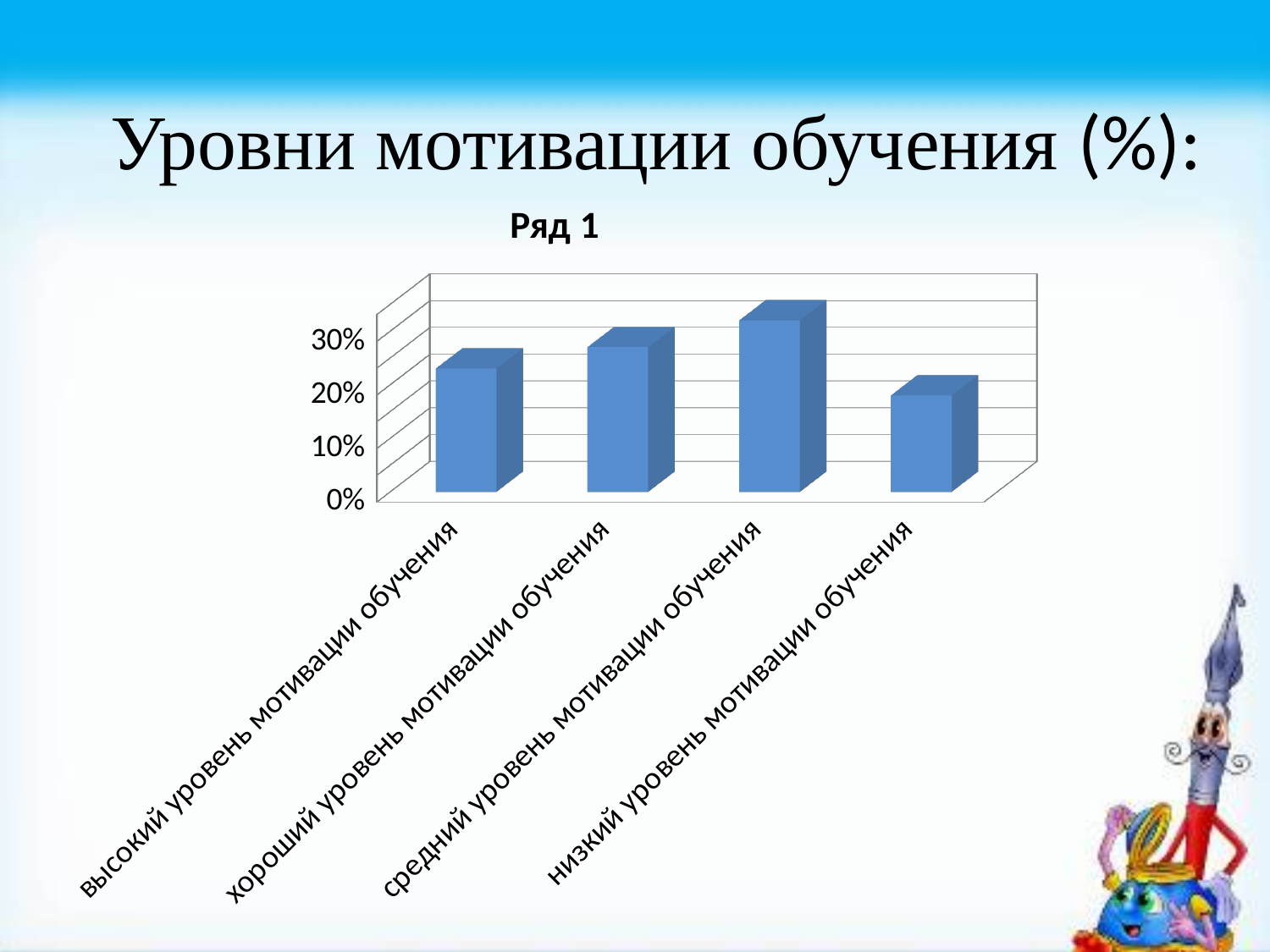
Which category has the lowest value? низкий уровень мотивации обучения What is the title shown above the chart? Ряд 1 What kind of chart is shown on the slide? bar chart Is the value for высокий уровень мотивации обучения greater or less than 20%? greater Which is larger: the value for хороший уровень мотивации обучения or for высокий уровень мотивации обучения? хороший уровень мотивации обучения Is the value for хороший уровень мотивации обучения greater or less than 20%? greater Is the value for низкий уровень мотивации обучения greater or less than 10%? greater Which category has the highest value? средний уровень мотивации обучения How many categories are plotted in the chart? 4 Which is larger: the value for средний уровень мотивации обучения or for хороший уровень мотивации обучения? средний уровень мотивации обучения Which is larger: the value for средний уровень мотивации обучения or for низкий уровень мотивации обучения? средний уровень мотивации обучения